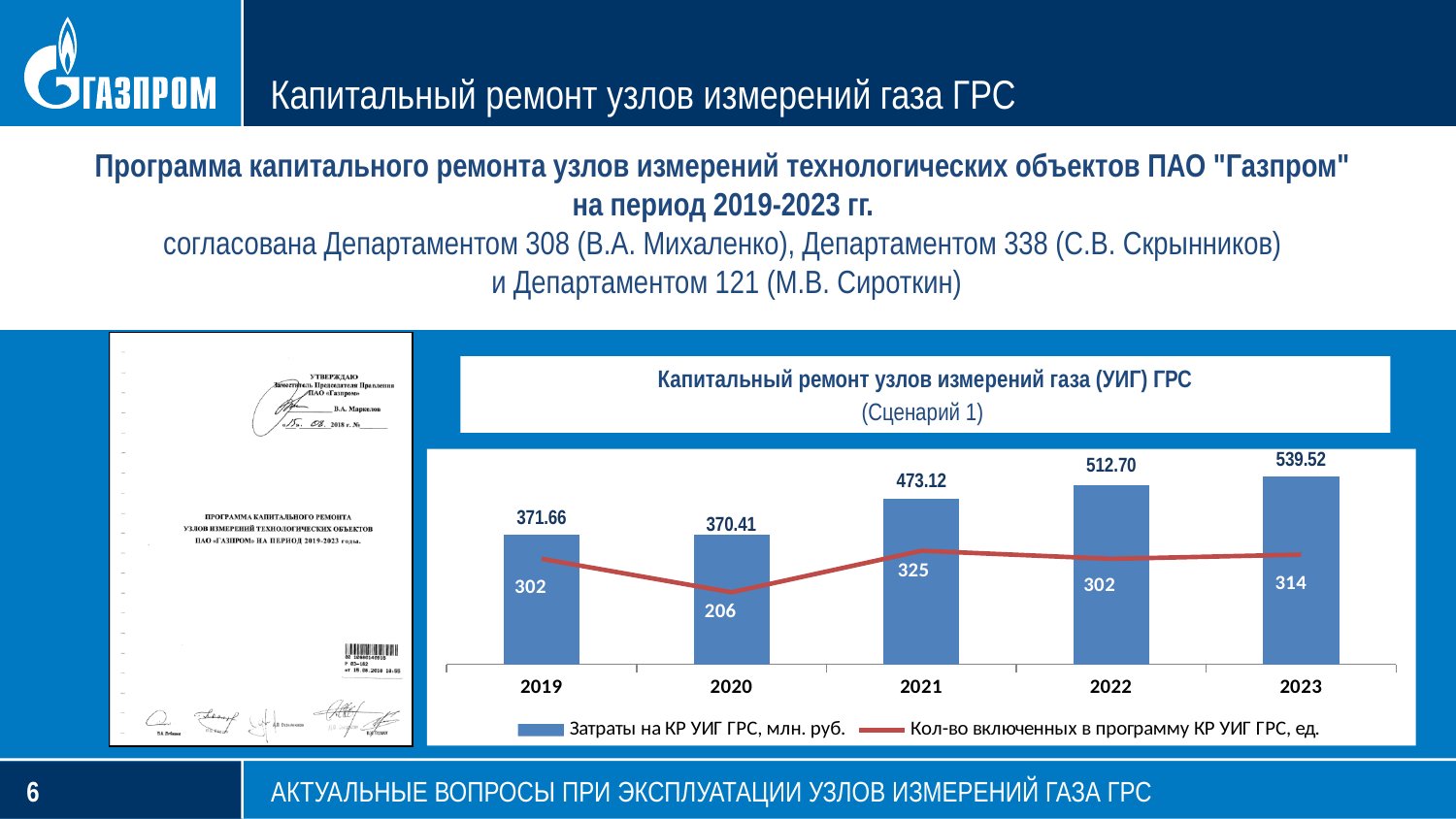
How many years are shown on the x axis of the chart? 5 What is the value of 'Кол-во включенных в программу КР УИГ ГРС, ед.' for 2020? 206 What is the title of the chart? Капитальный ремонт узлов измерений газа (УИГ) ГРС (Сценарий 1) What is the value of 'Затраты на КР УИГ ГРС, млн. руб.' for 2021? 473.12 What kind of chart is shown on the slide? Combined bar and line chart Which is larger: the 'Затраты на КР УИГ ГРС, млн. руб.' value for 2021 or for 2022? 2022 Which year has the highest value of 'Затраты на КР УИГ ГРС, млн. руб.'? 2023 What is the value of 'Затраты на КР УИГ ГРС, млн. руб.' for 2023? 539.52 How many series does the chart legend list? 2 What is the difference between the 'Затраты на КР УИГ ГРС, млн. руб.' values for 2023 and 2022? 26.82 Which year has the lowest value of 'Кол-во включенных в программу КР УИГ ГРС, ед.'? 2020 What is the difference between the 'Кол-во включенных в программу КР УИГ ГРС, ед.' values for 2021 and 2020? 119